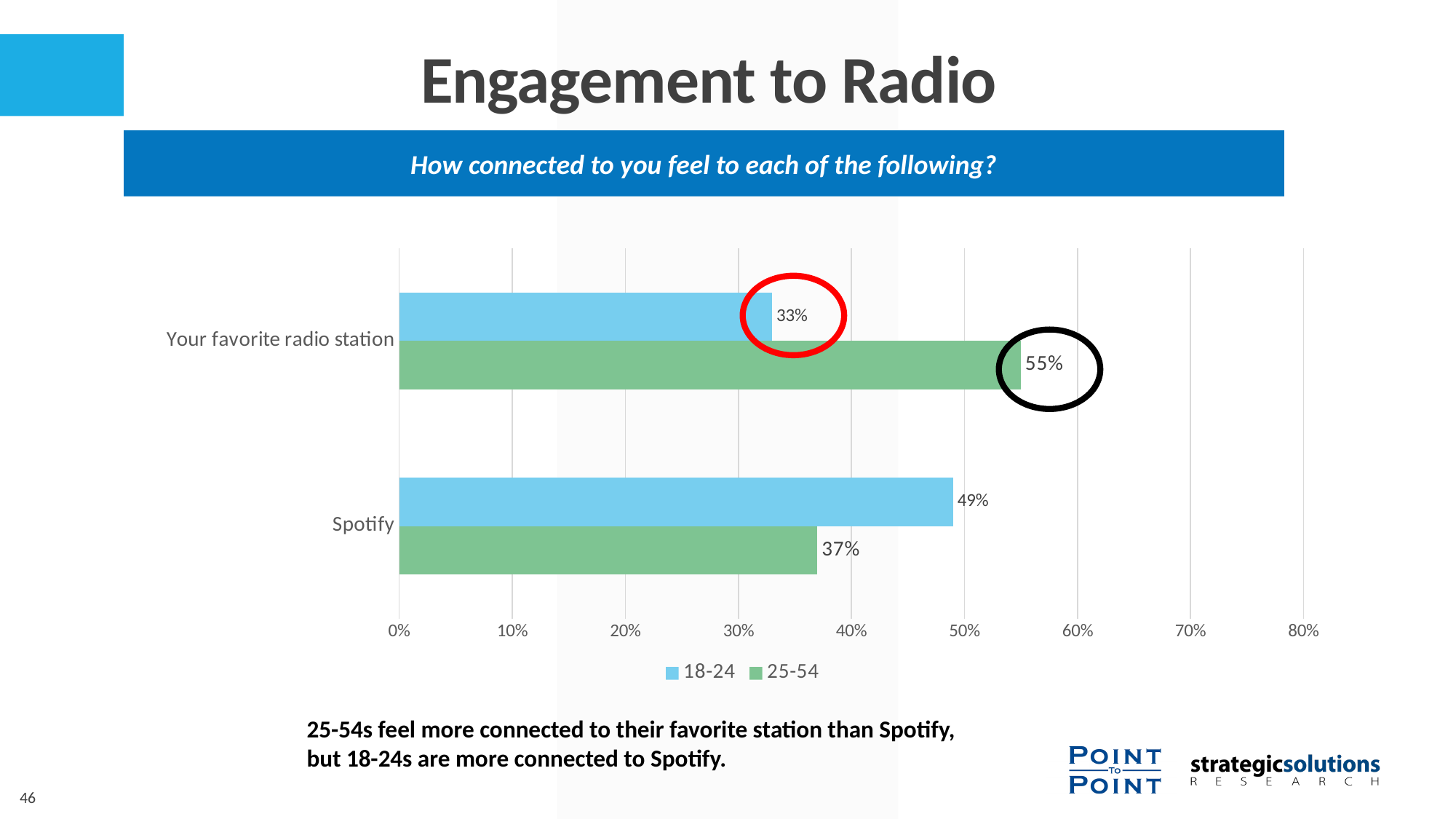
What percentage of 25-54s feel connected to Spotify? 37% How many series does the legend list? 2 Which category has the highest value for the 25-54 series? Your favorite radio station How many categories are shown on the chart? 2 For Spotify, which age group has the larger value, 18-24 or 25-54? 18-24 What percentage of 25-54s feel connected to their favorite radio station? 55% What is the difference between the 25-54 and 18-24 values for Your favorite radio station? 22% What percentage of 18-24s feel connected to their favorite radio station? 33% What is the difference between the 18-24 and 25-54 values for Spotify? 12% Which category has the lowest value for the 18-24 series? Your favorite radio station What kind of chart is shown on the slide? Bar chart What percentage of 18-24s feel connected to Spotify? 49%